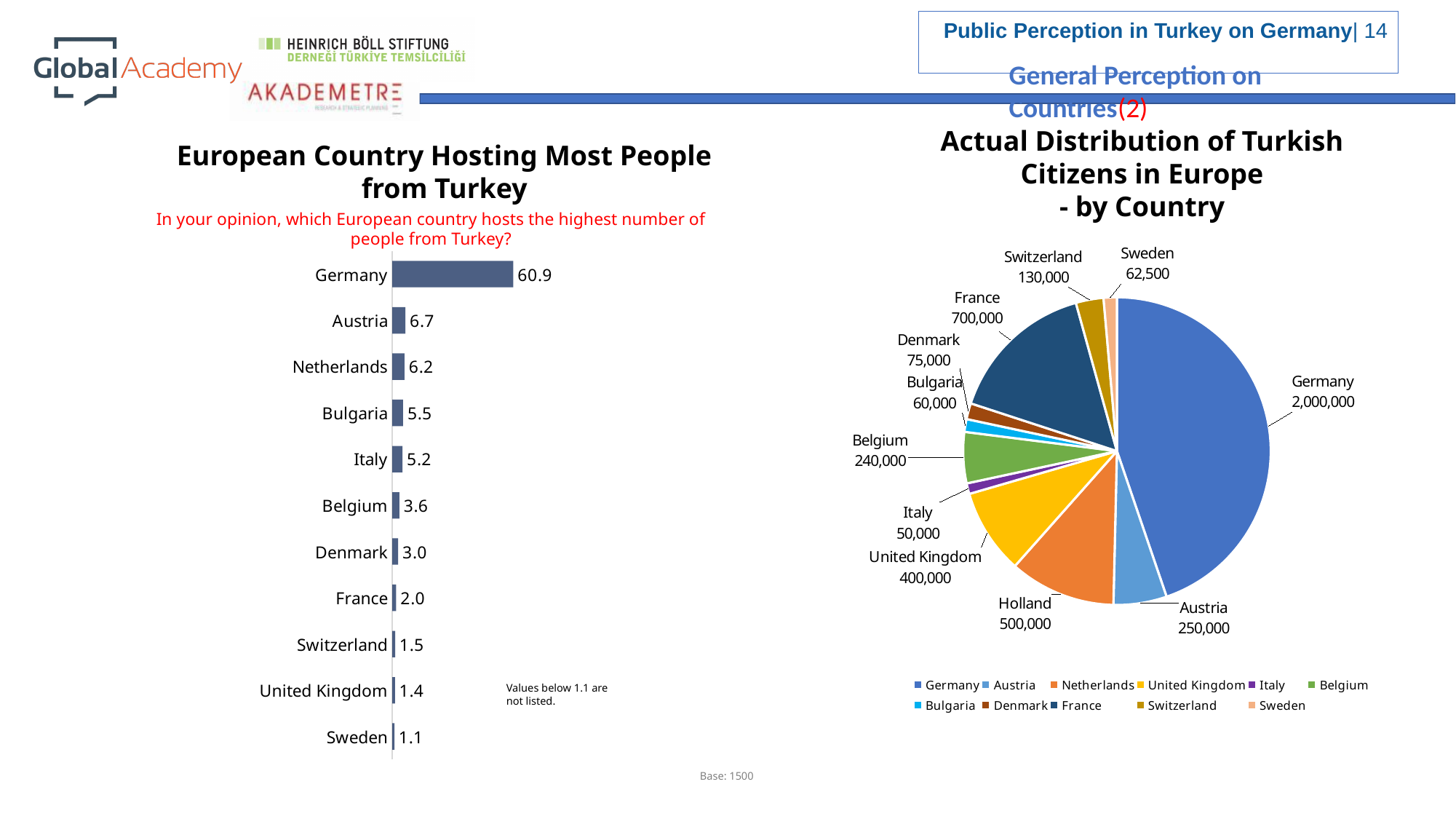
How many entries does the legend of the pie chart 'Actual Distribution of Turkish Citizens in Europe - by Country' list? 11 In the bar chart 'European Country Hosting Most People from Turkey', what is the value for Germany? 60.9 How many countries are listed in the bar chart 'European Country Hosting Most People from Turkey'? 11 In the bar chart 'European Country Hosting Most People from Turkey', which country has the lowest value? Sweden In the pie chart 'Actual Distribution of Turkish Citizens in Europe - by Country', what is the value for Sweden? 62,500 In the pie chart 'Actual Distribution of Turkish Citizens in Europe - by Country', which country has the largest slice? Germany What type of chart is 'European Country Hosting Most People from Turkey'? Bar chart In the bar chart 'European Country Hosting Most People from Turkey', what is the value for Bulgaria? 5.5 In the pie chart 'Actual Distribution of Turkish Citizens in Europe - by Country', what is the difference between the values for Holland and United Kingdom? 100,000 In the pie chart 'Actual Distribution of Turkish Citizens in Europe - by Country', what is the value for France? 700,000 In the bar chart 'European Country Hosting Most People from Turkey', which has a higher value, Belgium or Denmark? Belgium In the bar chart 'European Country Hosting Most People from Turkey', what is the difference between the values for Austria and Netherlands? 0.5